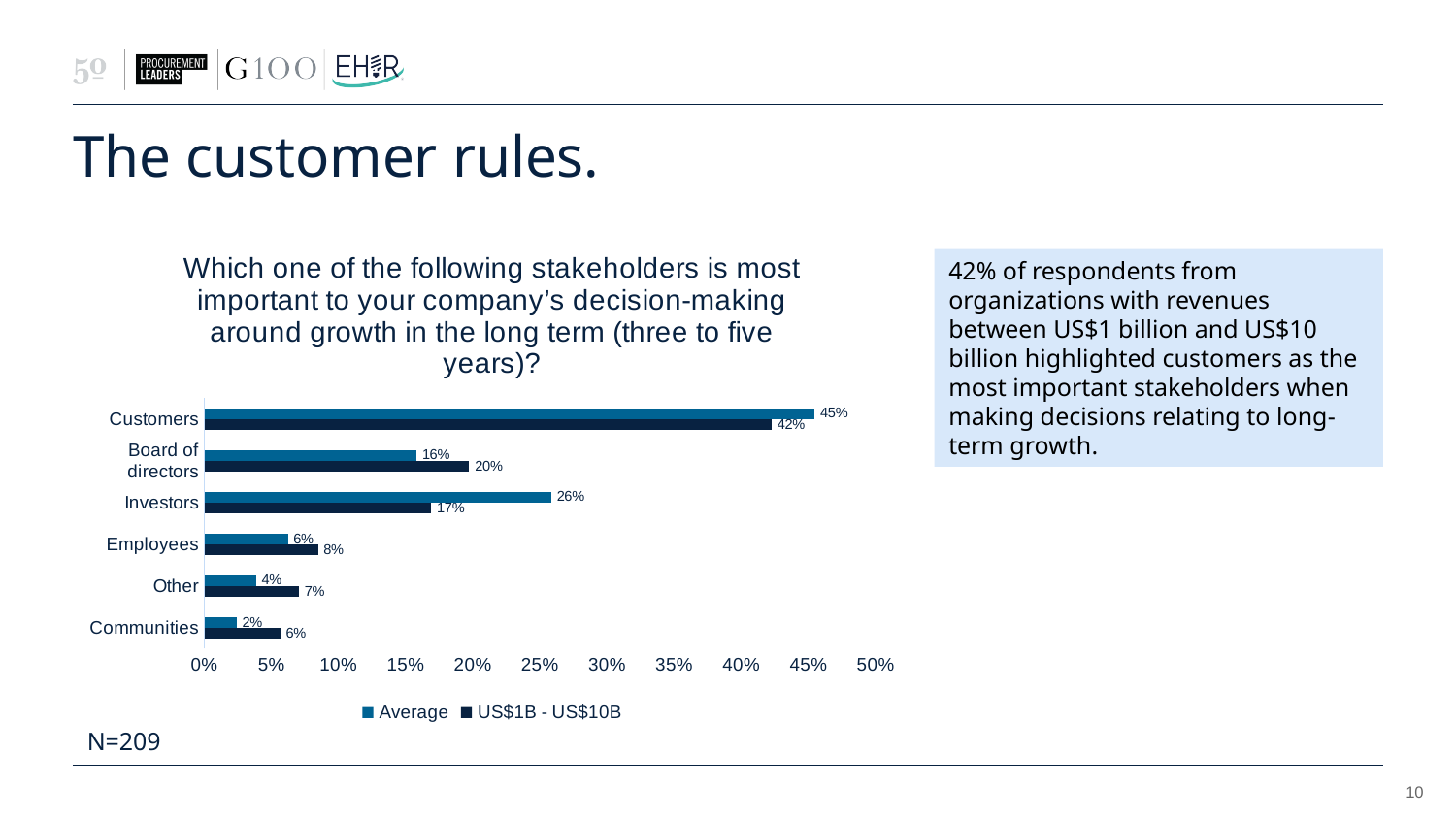
What is the US$1B - US$10B value for Board of directors? 20% What is the Average value for Investors? 26% How many series does the legend list? 2 Which stakeholder has the highest Average value? Customers Is the US$1B - US$10B value for Customers greater or less than 40%? greater How many stakeholder categories are shown on the chart? 6 What is the difference between the Average and US$1B - US$10B values for Investors? 9% What is the Average value for Customers? 45% What kind of chart is shown on the slide? Bar chart Which stakeholder has the lowest US$1B - US$10B value? Communities What is the US$1B - US$10B value for Communities? 6% Which is larger for Board of directors: the Average value or the US$1B - US$10B value? US$1B - US$10B